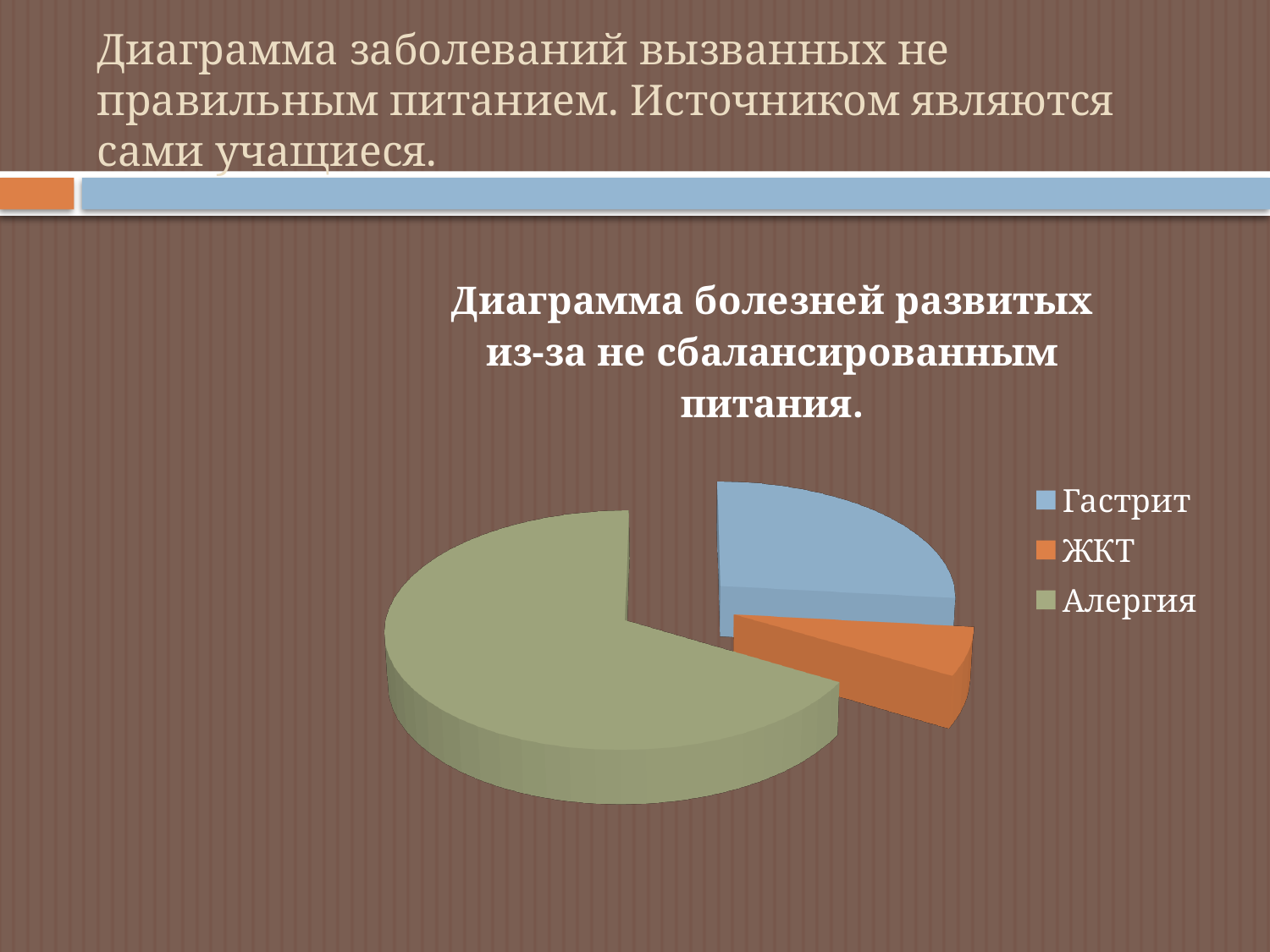
Which slice is larger, Гастрит or ЖКТ? Гастрит Which slice is larger, Алергия or Гастрит? Алергия Which category has the largest slice of the pie chart? Алергия What is the title of the pie chart? Диаграмма болезней развитых из-за не сбалансированным питания. How many slices does the pie chart have? 3 How many entries does the legend of the pie chart list? 3 What kind of chart is shown on the slide? Pie chart What colour is the slice for ЖКТ in the pie chart? Orange Which category has the smallest slice of the pie chart? ЖКТ